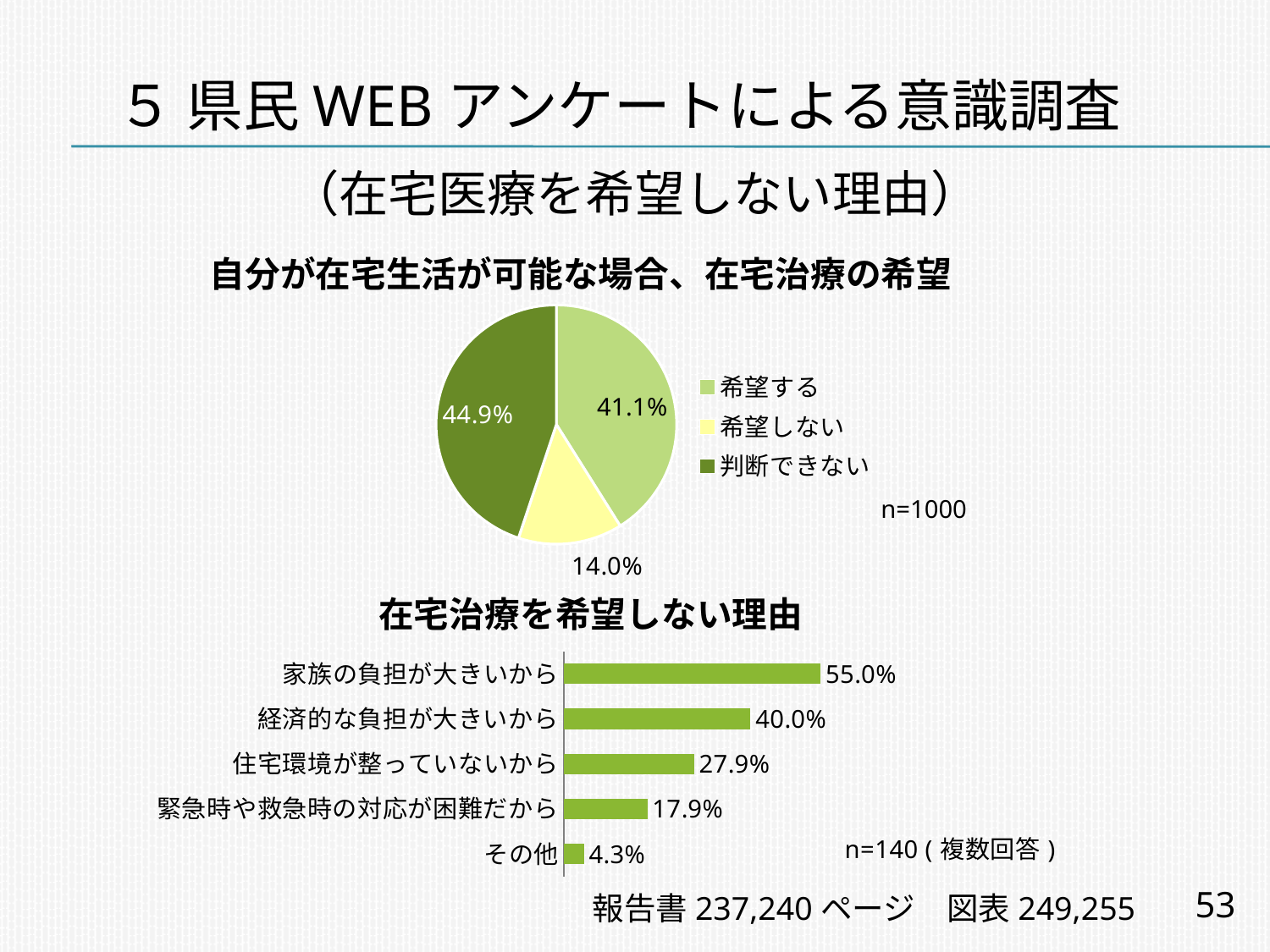
In the pie chart titled 自分が在宅生活が可能な場合、在宅治療の希望, what share is 希望しない? 14.0% In the bar chart titled 在宅治療を希望しない理由, what is the value for 経済的な負担が大きいから? 40.0% In the pie chart titled 自分が在宅生活が可能な場合、在宅治療の希望, which category has the largest share? 判断できない In the pie chart titled 自分が在宅生活が可能な場合、在宅治療の希望, what share is 希望する? 41.1% What kind of chart is the chart titled 在宅治療を希望しない理由? bar chart In the bar chart titled 在宅治療を希望しない理由, what is the value for 緊急時や救急時の対応が困難だから? 17.9% In the bar chart titled 在宅治療を希望しない理由, what is the difference between 家族の負担が大きいから and 住宅環境が整っていないから? 27.1% In the pie chart titled 自分が在宅生活が可能な場合、在宅治療の希望, what is the difference between 判断できない and 希望する? 3.8% In the bar chart titled 在宅治療を希望しない理由, which category has the highest value? 家族の負担が大きいから In the pie chart titled 自分が在宅生活が可能な場合、在宅治療の希望, how many slices are there? 3 In the bar chart titled 在宅治療を希望しない理由, how many categories are shown? 5 In the pie chart titled 自分が在宅生活が可能な場合、在宅治療の希望, which category has the smallest share? 希望しない